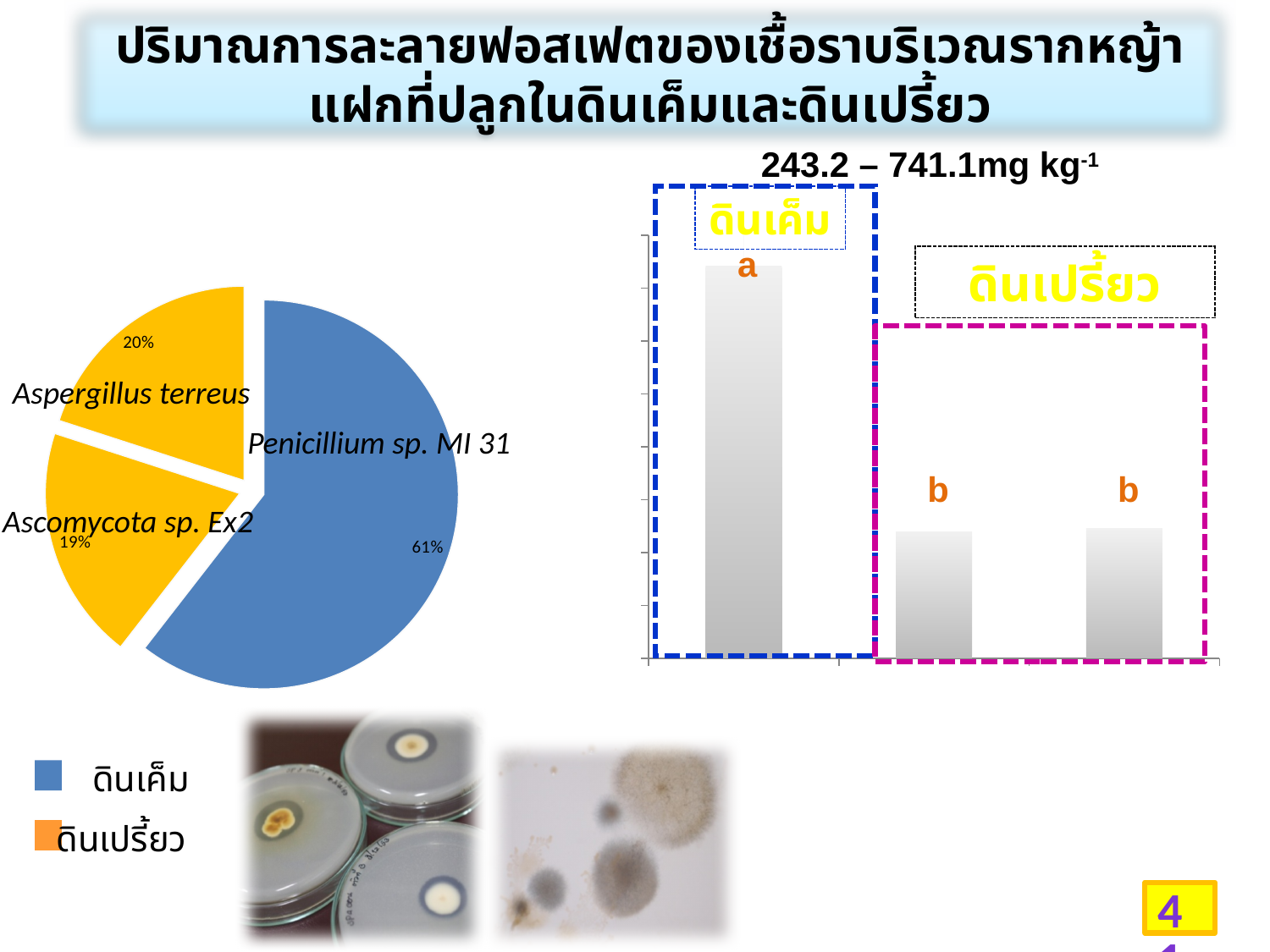
In the pie chart on the left, what share does Penicillium sp. MI 31 have? 61% What kind of chart is the chart on the right of the slide? bar chart In the pie chart on the left, which slice is the largest? Penicillium sp. MI 31 In the pie chart on the left, what is the difference in percentage points between Penicillium sp. MI 31 and Aspergillus terreus? 41 In the pie chart on the left, which is larger, the share of Penicillium sp. MI 31 or the share of Ascomycota sp. Ex2? Penicillium sp. MI 31 In the bar chart on the right, which group contains the tallest bar, ดินเค็ม or ดินเปรี้ยว? ดินเค็ม In the pie chart on the left, which slice is the smallest? Ascomycota sp. Ex2 In the pie chart on the left, what share does Aspergillus terreus have? 20% In the bar chart on the right, how many bars are plotted? 3 What kind of chart is the chart on the left of the slide? pie chart In the pie chart on the left, how many slices are there? 3 In the pie chart on the left, what share does Ascomycota sp. Ex2 have? 19%